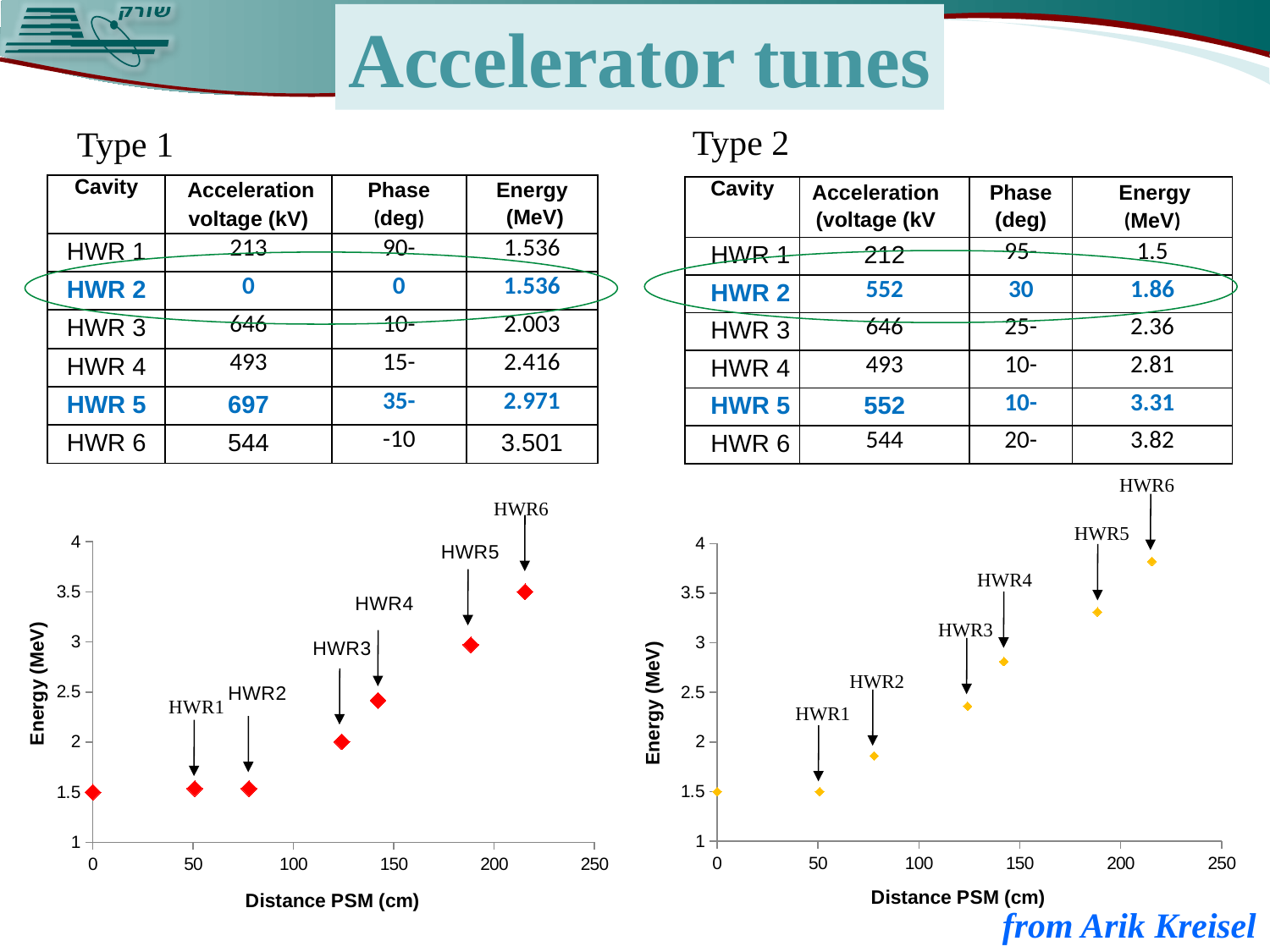
In the Type 2 chart, do the energy values rise or fall as distance increases? rise In the Type 2 chart, which labeled point has the lowest energy? HWR1 In the Type 1 chart, which labeled point has the highest energy? HWR6 In the Type 1 chart, which has the higher energy, HWR4 or HWR5? HWR5 What is the y-axis title of the Type 2 chart? Energy (MeV) What kind of chart is the Type 1 chart on the left? scatter chart What is the x-axis title of the Type 1 chart? Distance PSM (cm) In the Type 2 chart, is the energy for HWR5 greater or less than 3? greater In the Type 2 chart, is the energy for HWR3 greater or less than 2.5? less In the Type 1 chart, how many points are labeled with HWR names? 6 In the Type 1 chart, is the energy for HWR6 greater or less than 3? greater